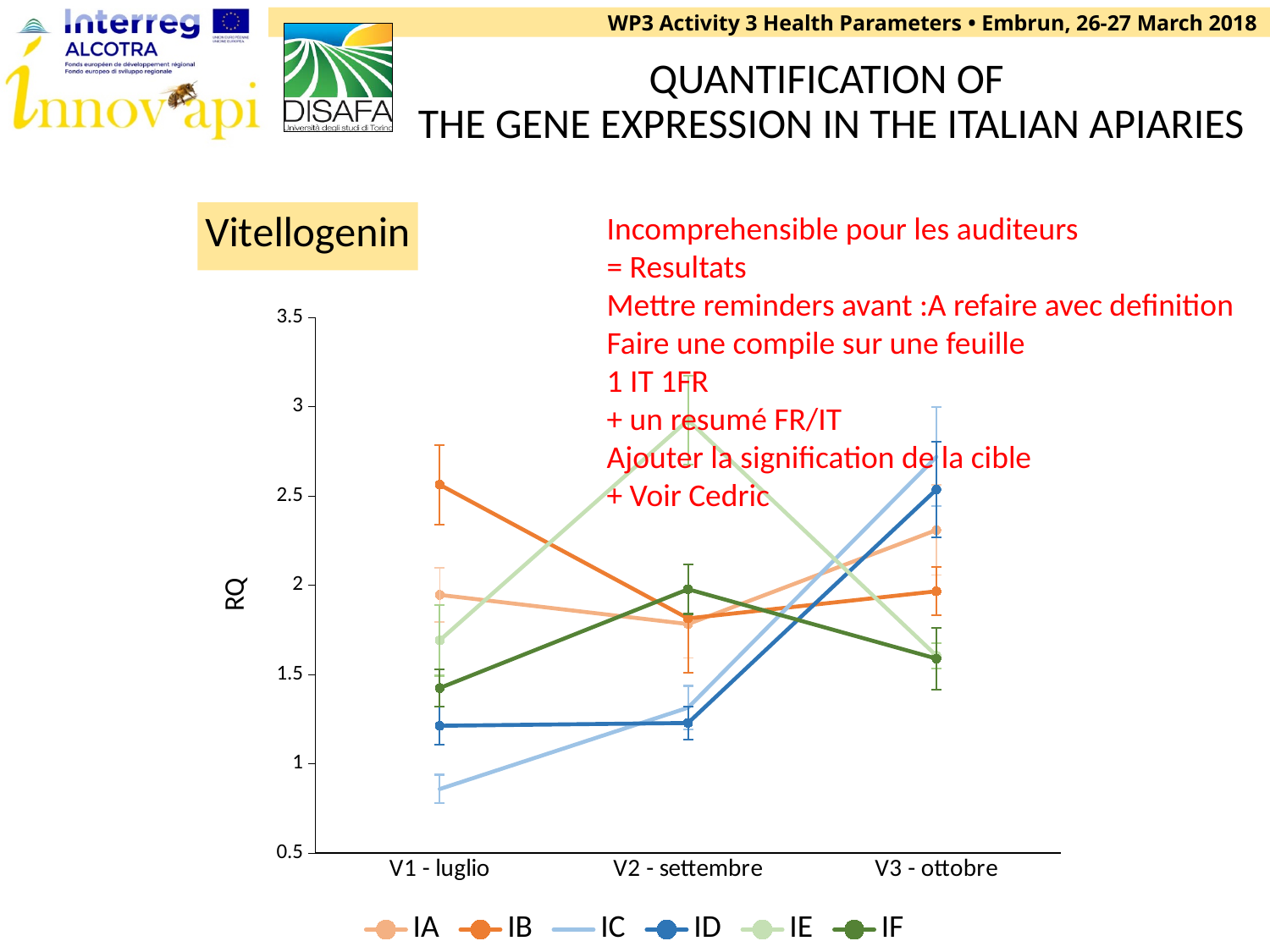
Is the value for ID at V2 - settembre greater or less than 1.5? less Is the value for IE at V2 - settembre greater or less than 2.5? greater How many series does the legend list? 6 Which gene is the chart about, according to the highlighted label above it? Vitellogenin Which series has the lowest value at V1 - luglio? IC What kind of chart is shown on the slide? line chart Is the value for IC at V1 - luglio greater or less than 1? less How many sampling points (categories) are shown on the x axis? 3 At V3 - ottobre, which is larger, ID or IF? ID What is the label of the y axis? RQ Which series has the highest value at V1 - luglio? IB